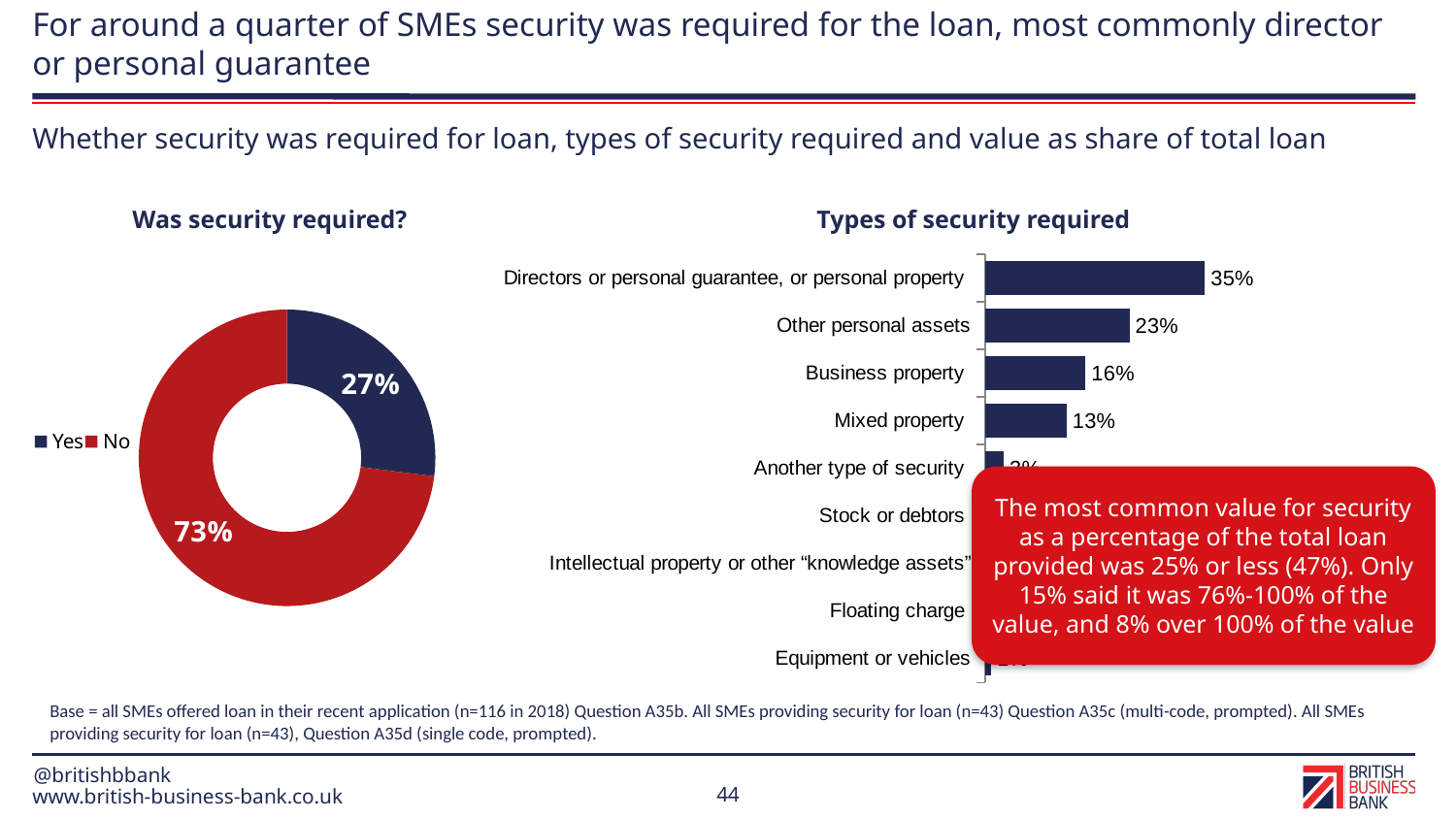
In the 'Types of security required' chart, what is the value for 'Business property'? 16% In the 'Was security required?' chart, what percentage of SMEs said No? 73% In the 'Types of security required' chart, what is the value for 'Directors or personal guarantee, or personal property'? 35% In the 'Types of security required' chart, what kind of chart is shown? Bar chart In the 'Was security required?' chart, which slice is larger, Yes or No? No In the 'Types of security required' chart, what is the difference between 'Directors or personal guarantee, or personal property' and 'Other personal assets'? 12 percentage points In the 'Types of security required' chart, what is the value for 'Other personal assets'? 23% In the 'Was security required?' chart, how many entries does the legend list? 2 In the 'Was security required?' chart, what percentage of SMEs said Yes? 27% In the 'Types of security required' chart, which type of security has the highest value? Directors or personal guarantee, or personal property In the 'Was security required?' chart, what kind of chart is shown? Doughnut (pie) chart In the 'Types of security required' chart, what is the value for 'Mixed property'? 13%